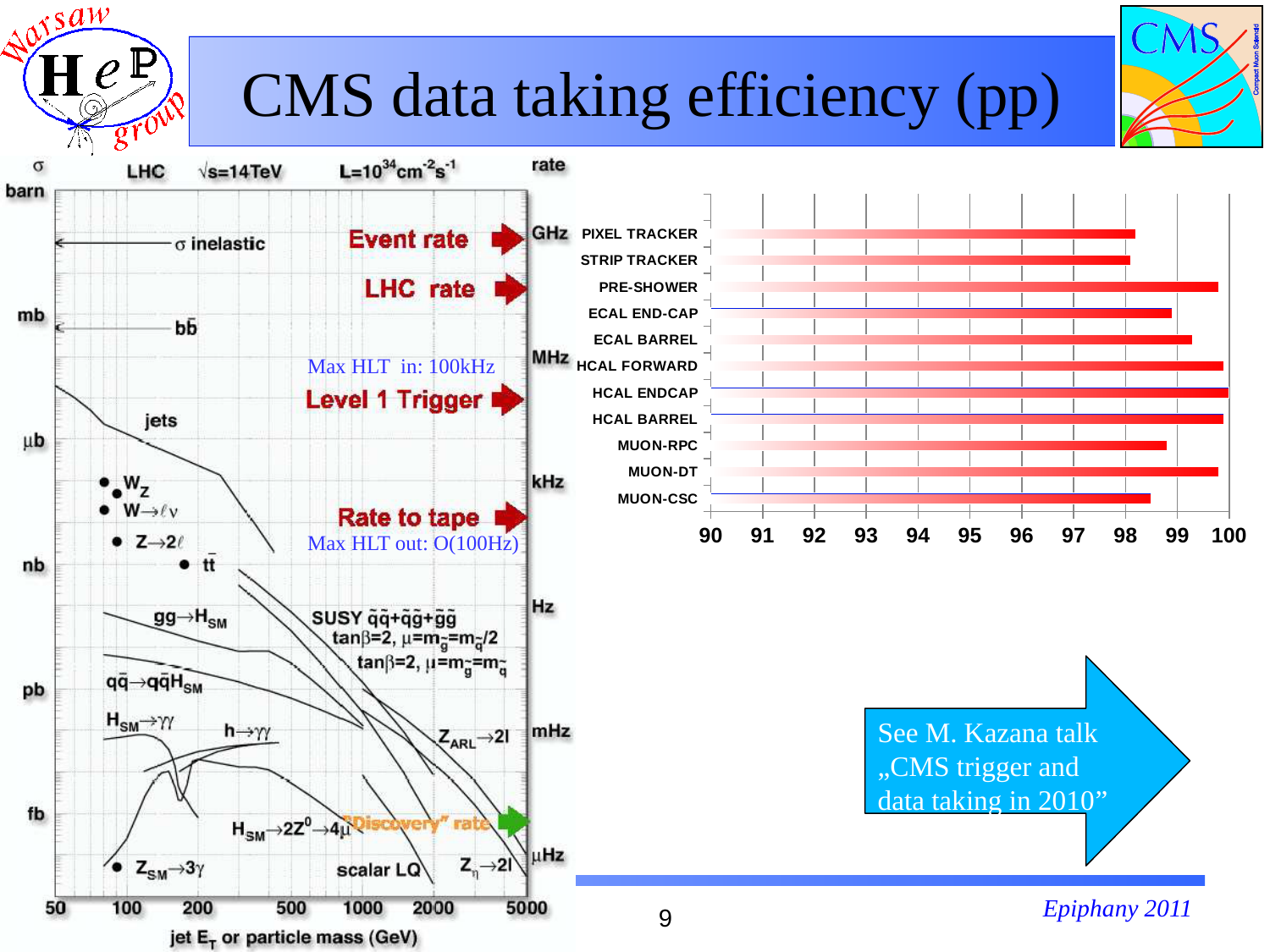
In the bar chart on the right, is the value for PIXEL TRACKER greater or less than 99? less In the bar chart on the right, is the value for ECAL BARREL greater or less than 99? greater In the bar chart on the right, which is larger, the value for HCAL FORWARD or the value for STRIP TRACKER? HCAL FORWARD In the bar chart on the right, how many subdetector categories are listed? 11 In the bar chart on the right, is the value for MUON-CSC greater or less than 99? less In the bar chart on the right, which is larger, the value for PRE-SHOWER or the value for PIXEL TRACKER? PRE-SHOWER In the bar chart on the right, what is the lowest value shown on the horizontal axis? 90 In the bar chart on the right, which is larger, the value for MUON-DT or the value for MUON-CSC? MUON-DT What kind of chart is shown on the right side of the slide? bar chart